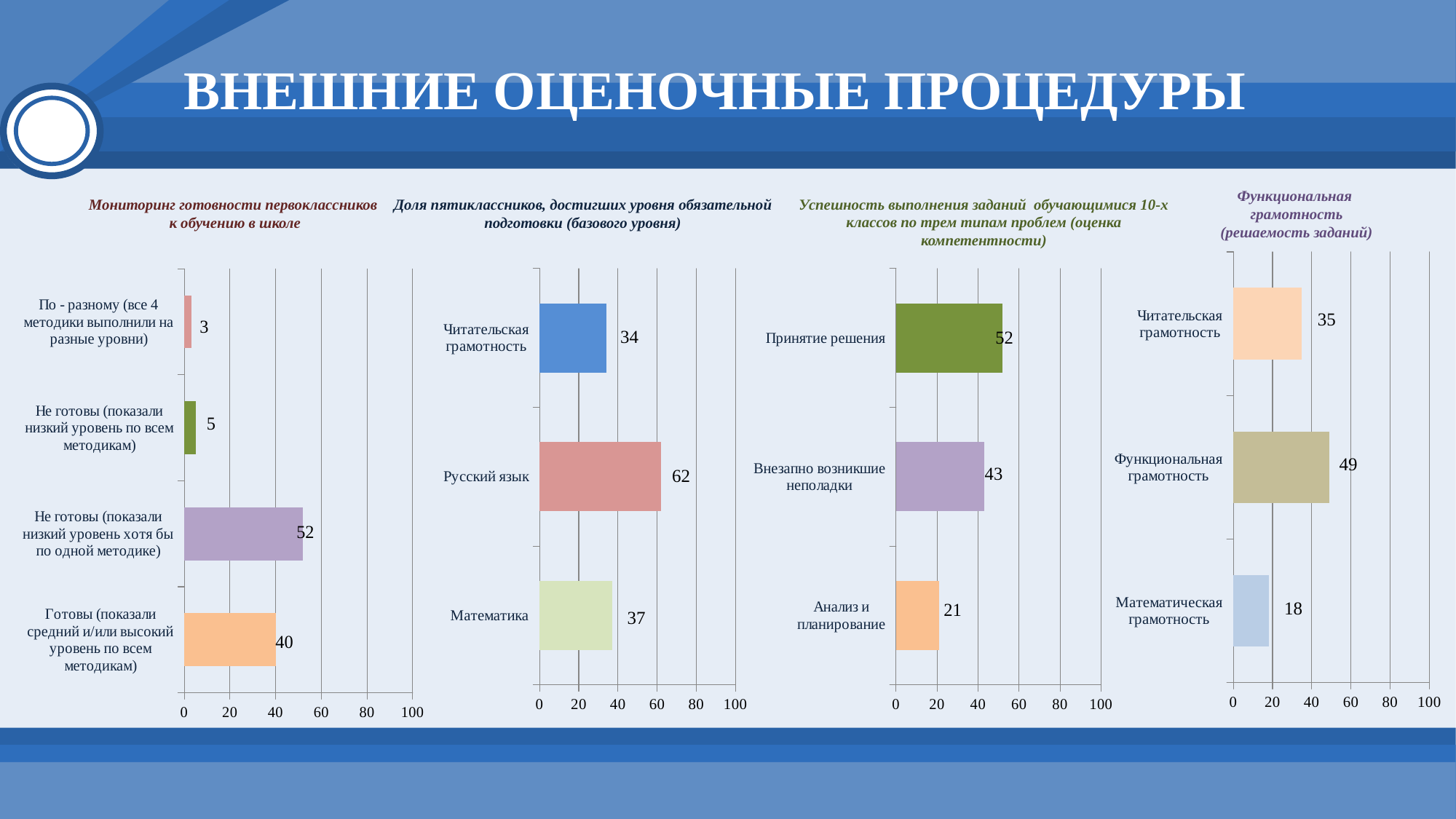
In the chart «Доля пятиклассников, достигших уровня обязательной подготовки», what is the difference between Русский язык and Читательская грамотность? 28 In the rightmost chart «Функциональная грамотность (решаемость заданий)», what is the value for Математическая грамотность? 18 How many categories are shown in the leftmost chart (Мониторинг готовности первоклассников)? 4 In the chart «Успешность выполнения заданий обучающимися 10-х классов», which category has the lowest value? Анализ и планирование In the leftmost chart (Мониторинг готовности первоклассников к обучению в школе), what is the value for «Готовы (показали средний и/или высокий уровень по всем методикам)»? 40 In the chart «Доля пятиклассников, достигших уровня обязательной подготовки (базового уровня)», what is the value for Русский язык? 62 In the chart «Успешность выполнения заданий обучающимися 10-х классов по трем типам проблем», what is the value for Внезапно возникшие неполадки? 43 In the leftmost chart (Мониторинг готовности первоклассников), which category has the lowest value? По - разному (все 4 методики выполнили на разные уровни) In the leftmost chart (Мониторинг готовности первоклассников), which category has the highest value? Не готовы (показали низкий уровень хотя бы по одной методике) What type of chart is the chart «Функциональная грамотность (решаемость заданий)»? Bar chart In the chart «Доля пятиклассников, достигших уровня обязательной подготовки», which is larger: Математика or Читательская грамотность? Математика In the rightmost chart «Функциональная грамотность (решаемость заданий)», which category has the highest value? Функциональная грамотность